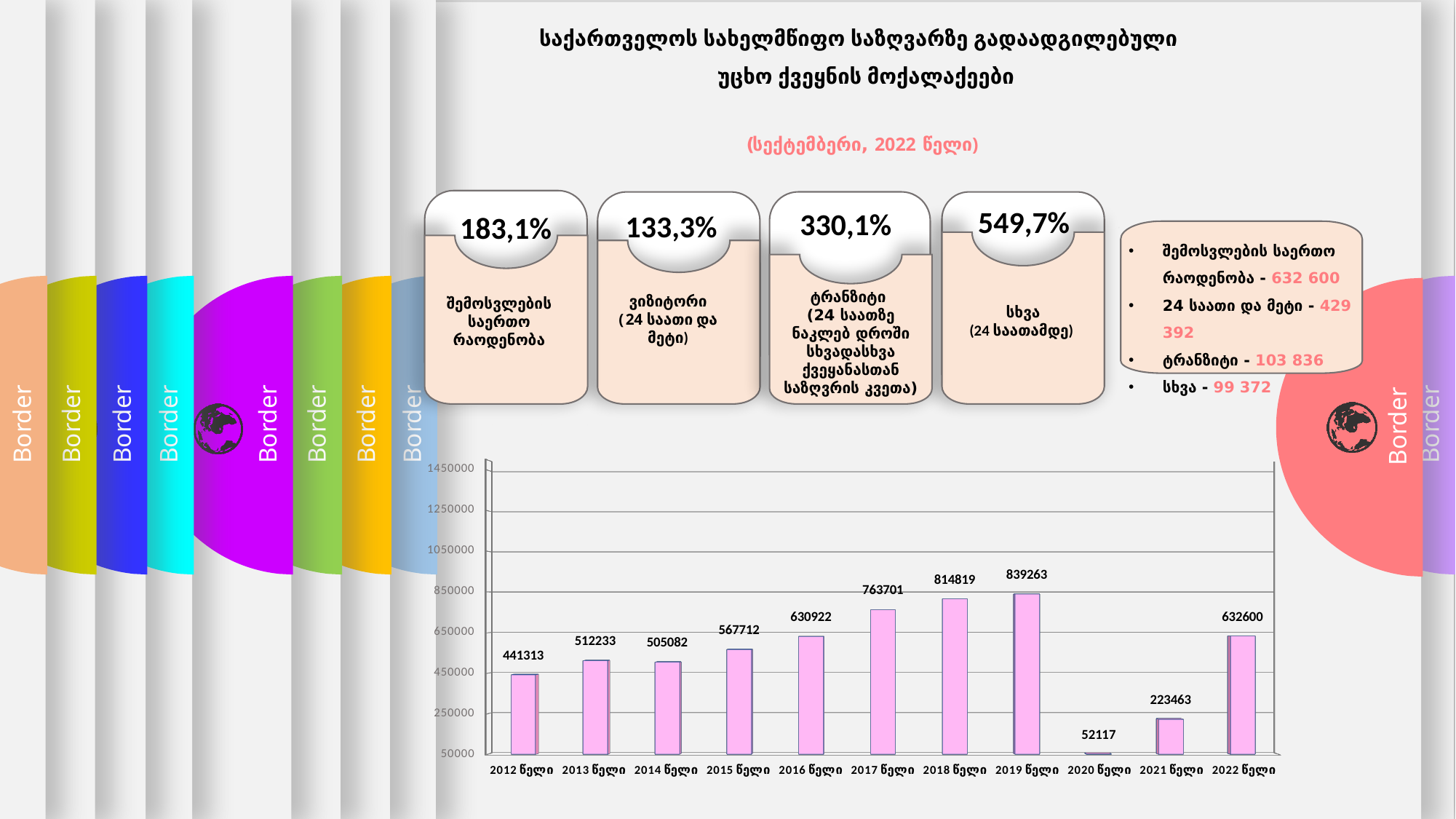
What is the value shown for 2020 (2020 წელი) in the bar chart? 52117 Which year has the highest bar in the chart? 2019 წელი What type of chart is shown at the bottom of the slide? bar chart Which year has the lowest bar in the chart? 2020 წელი What is the difference between the values for 2022 and 2021 in the bar chart? 409137 How many years (bars) are shown in the bar chart? 11 What is the value shown for 2019 (2019 წელი) in the bar chart? 839263 Which is larger in the bar chart, the value for 2013 or the value for 2014? 2013 წელი Do the values in the bar chart rise or fall from 2012 to 2019? rise What is the value shown for 2022 (2022 წელი) in the bar chart? 632600 Is the value for 2017 in the bar chart greater or less than 650000? greater What is the difference between the values for 2019 and 2020 in the bar chart? 787146